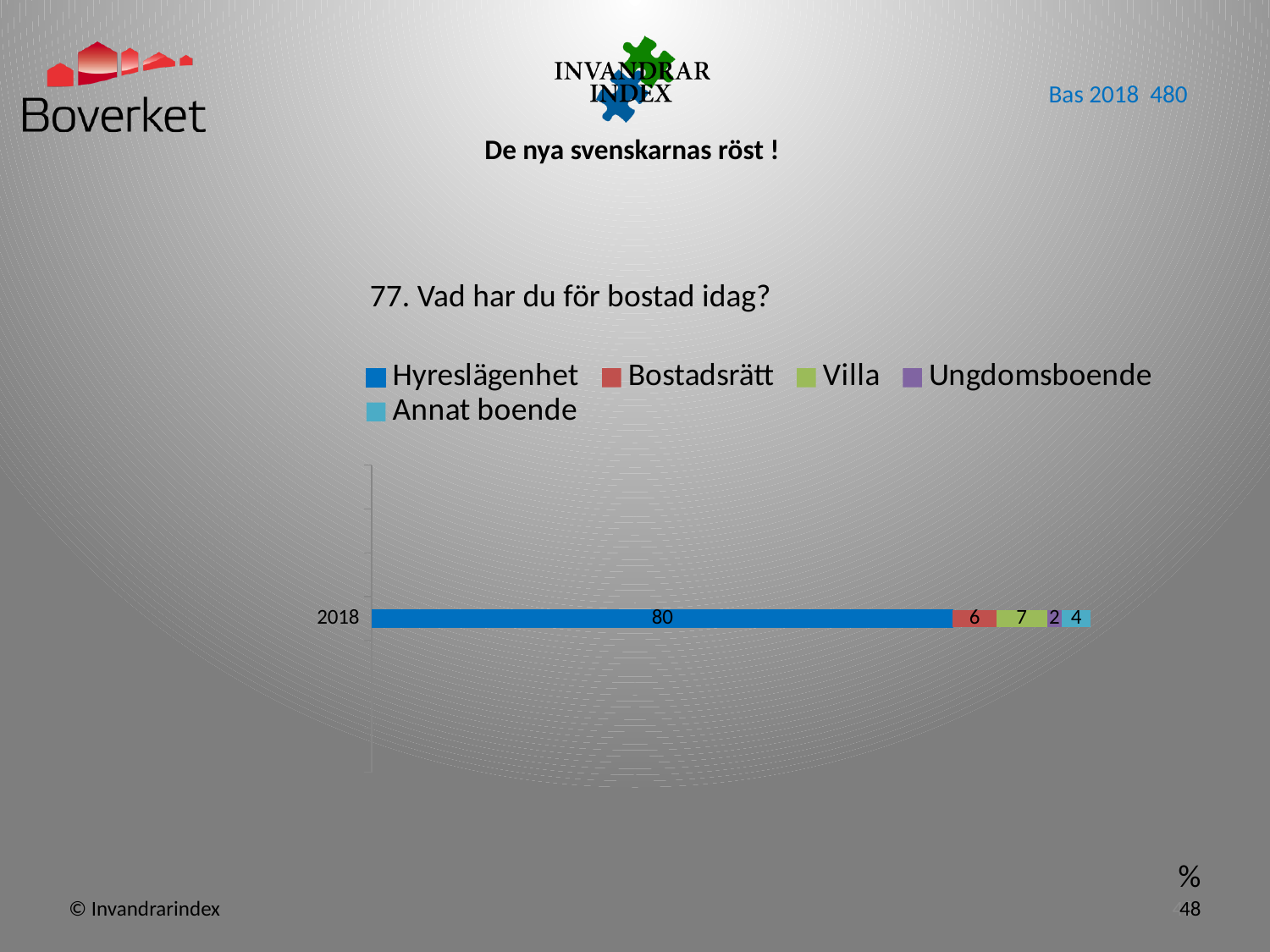
Which series has the lowest value in 2018? Ungdomsboende What is the value for Ungdomsboende in 2018? 2 Which is larger in 2018, Villa or Bostadsrätt? Villa What is the value for Annat boende in 2018? 4 What is the value for Bostadsrätt in 2018? 6 What is the difference between the values for Hyreslägenhet and Villa in 2018? 73 Which series has the highest value in 2018? Hyreslägenhet What is the value for Villa in 2018? 7 What is the total of the stacked bar for 2018? 99 What is the value for Hyreslägenhet in 2018? 80 How many series does the legend list? 5 What kind of chart is shown on the slide? Stacked bar chart